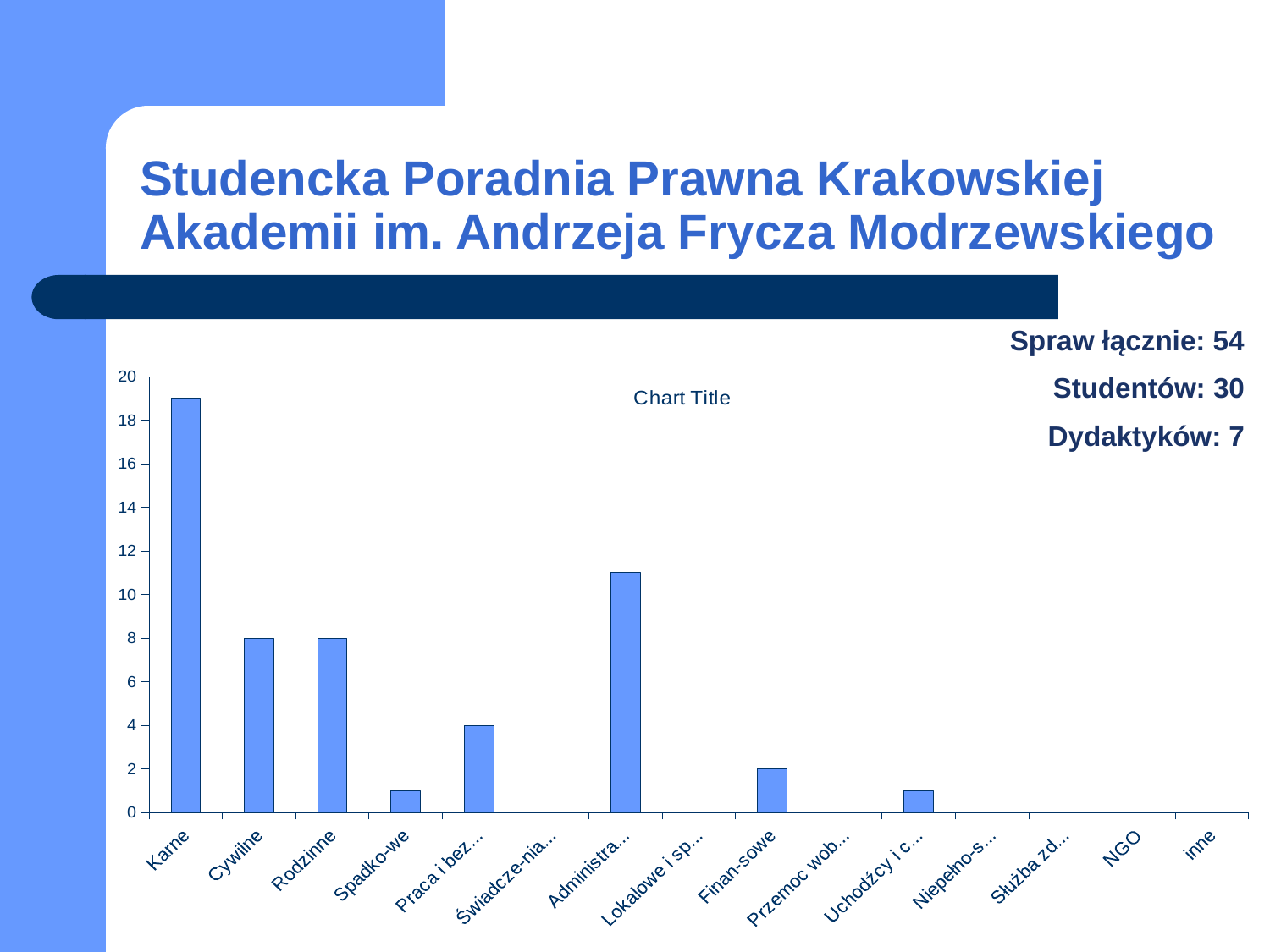
Which category has the highest value in the chart? Karne What is the value for Rodzinne? 8 Is the value for Karne greater or less than 18? greater Is the value for Administra... greater or less than 10? greater What type of chart is shown on the slide? bar chart What is the value for Finan-sowe? 2 Is the value for Spadko-we greater or less than 2? less Which is larger, the value for Karne or the value for Administra...? Karne What is the value for Cywilne? 8 What is the value for NGO? 0 How many categories are shown on the x axis of the chart? 15 What is the value for Praca i bez...? 4